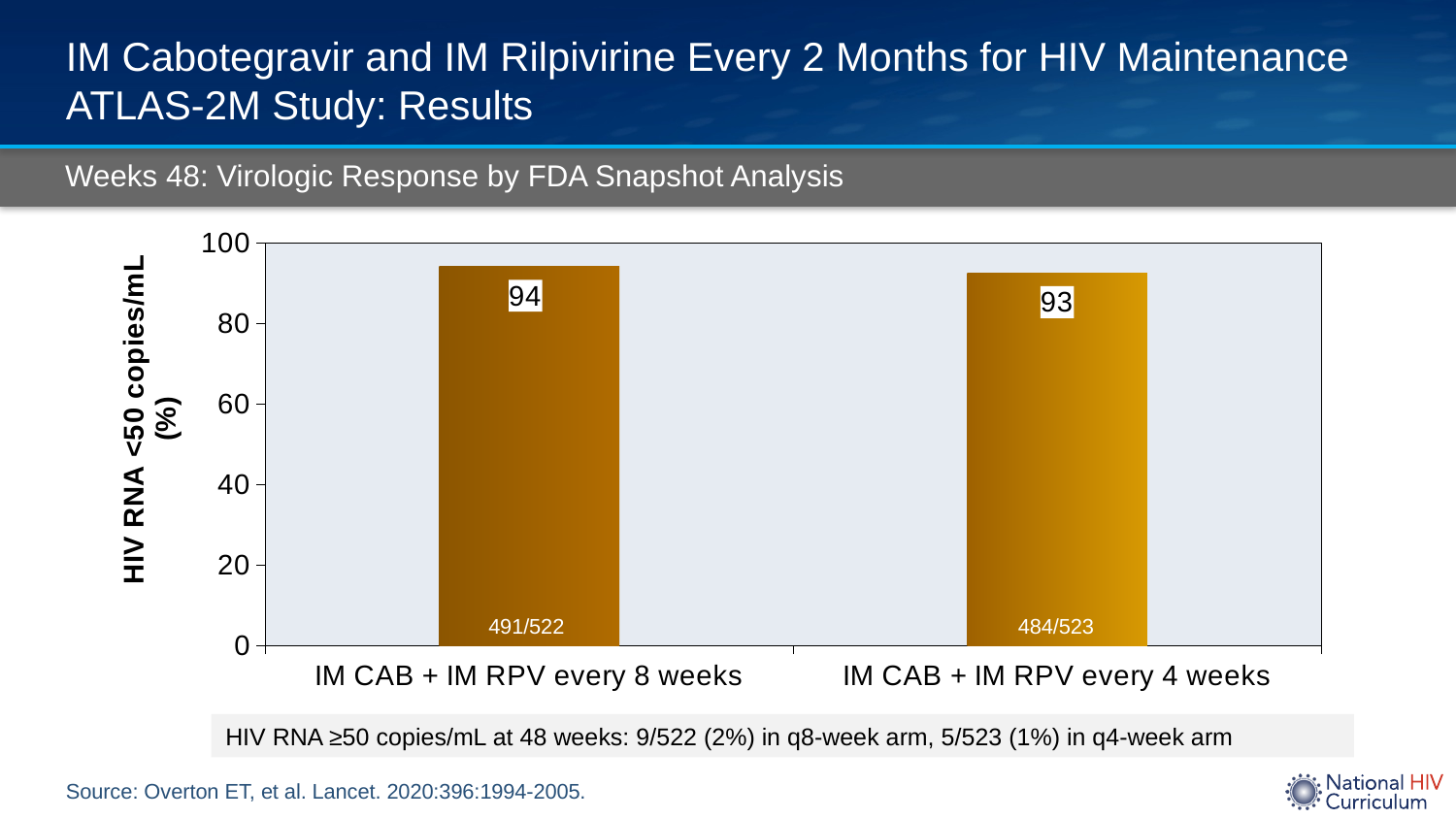
What is the value for IM CAB + IM RPV every 8 weeks? 94 What is the label of the y axis? HIV RNA <50 copies/mL (%) Is the value for IM CAB + IM RPV every 4 weeks greater or less than 80? greater How many categories are shown on the x axis? 2 Which is larger, the value for IM CAB + IM RPV every 8 weeks or IM CAB + IM RPV every 4 weeks? IM CAB + IM RPV every 8 weeks What fraction is printed inside the bar for IM CAB + IM RPV every 8 weeks? 491/522 What is the value for IM CAB + IM RPV every 4 weeks? 93 Which category has the highest value? IM CAB + IM RPV every 8 weeks Which category has the lowest value? IM CAB + IM RPV every 4 weeks What fraction is printed inside the bar for IM CAB + IM RPV every 4 weeks? 484/523 What kind of chart is shown on the slide? bar chart What is the difference between the values for IM CAB + IM RPV every 8 weeks and IM CAB + IM RPV every 4 weeks? 1